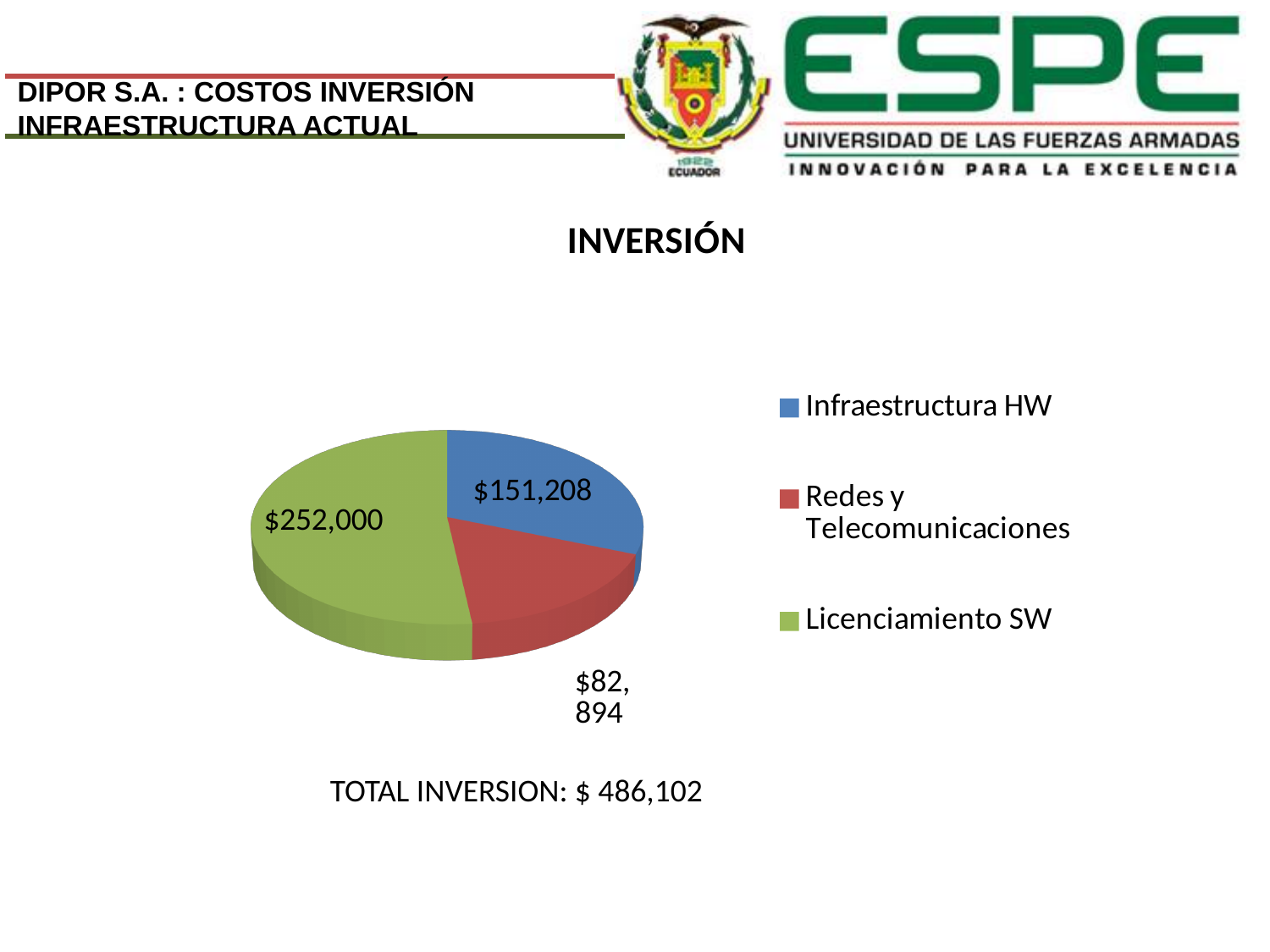
Which is larger, Infraestructura HW or Redes y Telecomunicaciones? Infraestructura HW What is the value for Infraestructura HW? $151,208 What is the value for Redes y Telecomunicaciones? $82,894 Which category has the largest slice of the pie? Licenciamiento SW What colour is the Licenciamiento SW slice? Green What is the value for Licenciamiento SW? $252,000 What type of chart is shown on the slide? Pie chart What is the difference between Licenciamiento SW and Infraestructura HW? $100,792 Which category has the smallest slice of the pie? Redes y Telecomunicaciones How many categories does the pie chart show? 3 What is the total investment shown on the slide? $ 486,102 What is the title of the chart? INVERSIÓN